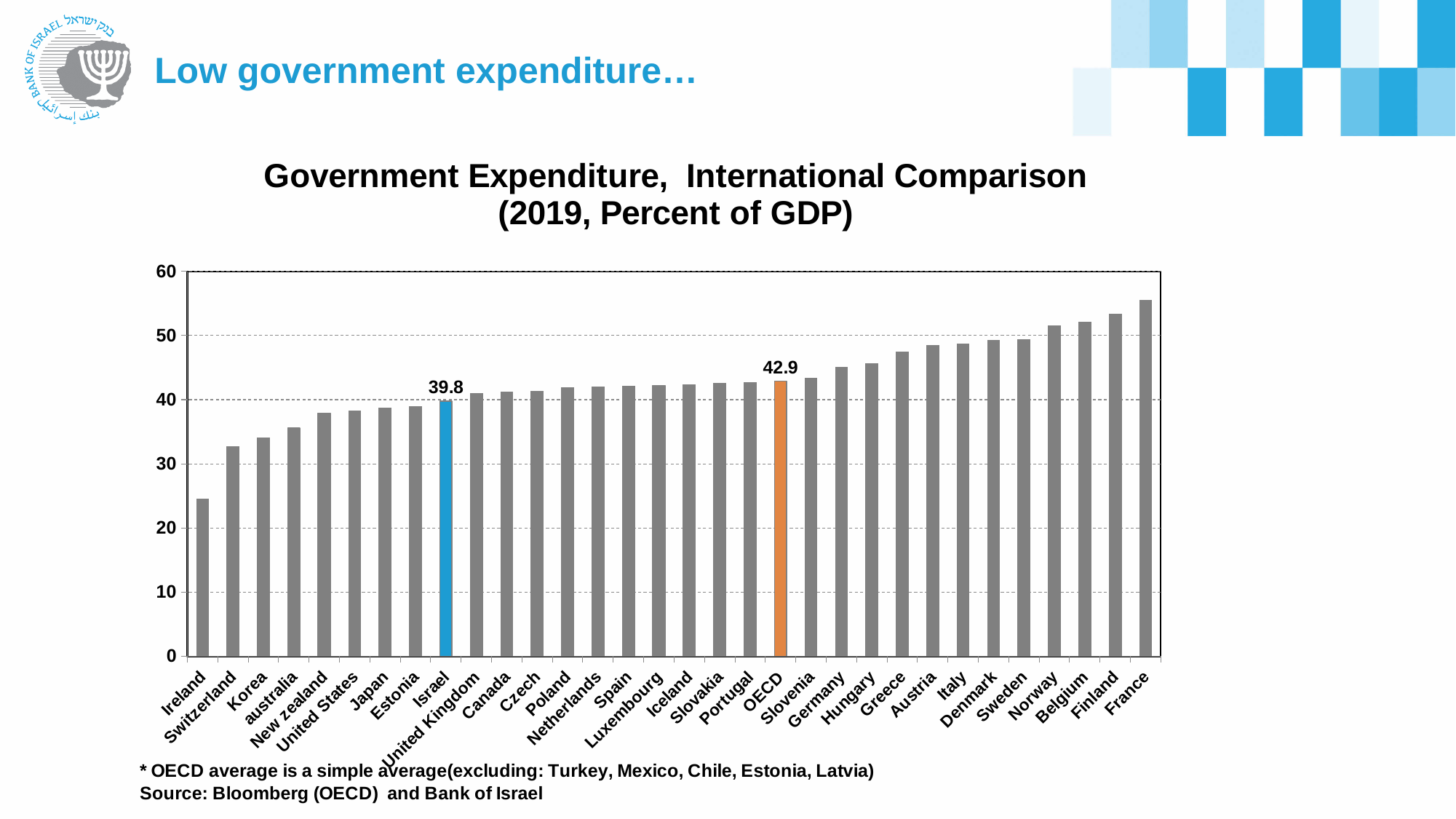
Which country has the highest government expenditure in the chart? France How many countries/categories are shown on the x axis? 32 What kind of chart is shown on the slide? bar chart Which is larger, the value for Israel or the value for OECD? OECD Is the value for France greater or less than 50? greater Is the value for Germany greater or less than 50? less Is the value for Ireland greater or less than 30? less What is the value for OECD? 42.9 What is the value for Israel? 39.8 Do the values rise or fall moving from left to right along the x axis? rise Which country has the lowest government expenditure in the chart? Ireland What is the difference between the OECD value and the Israel value? 3.1